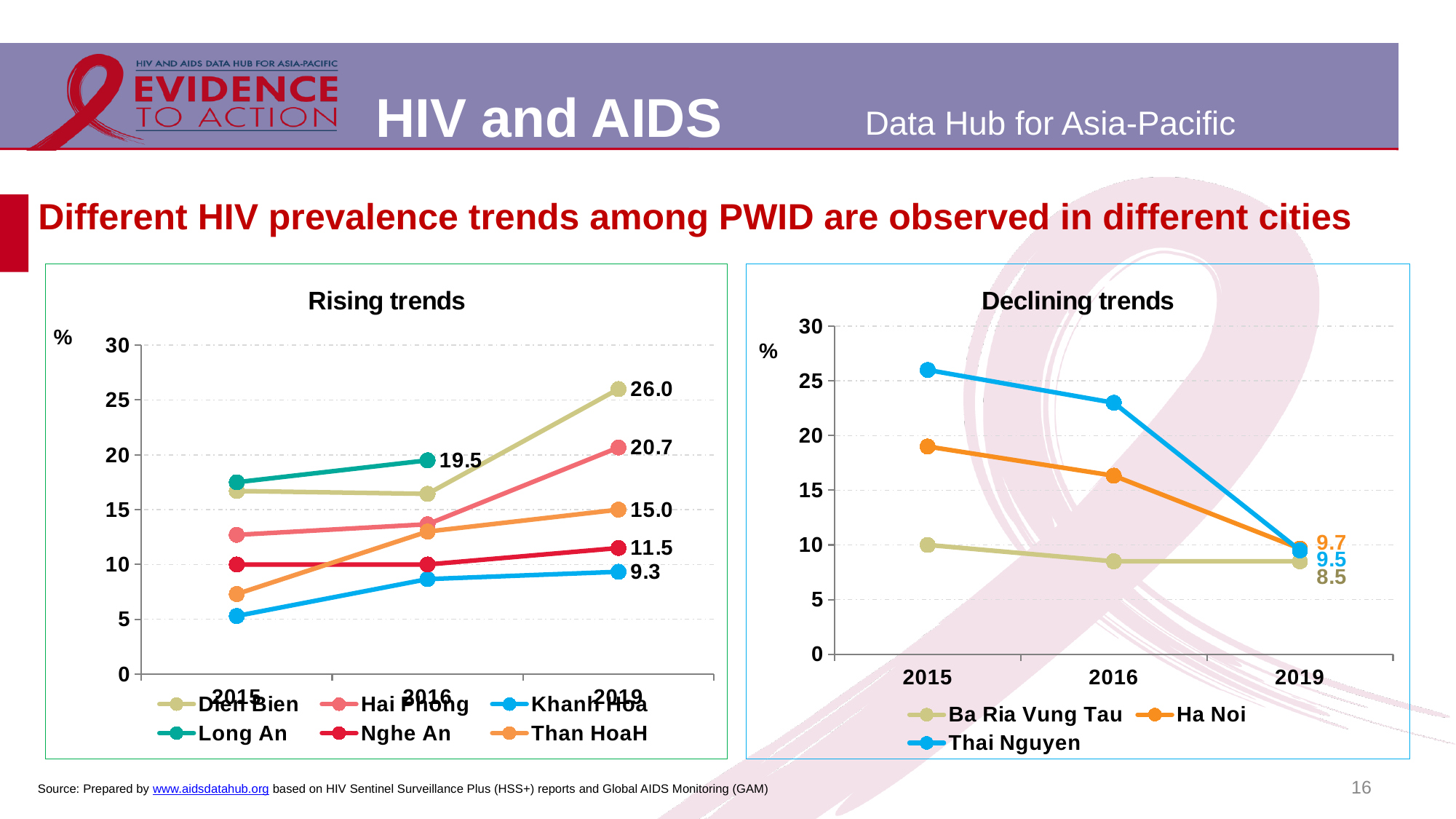
In the Rising trends chart, which city has the highest value in 2019? Dien Bien In the Rising trends chart, which city has the lowest value in 2019? Khanh Hoa In the Rising trends chart, what is the value for Dien Bien in 2019? 26.0 In the Declining trends chart, is the value for Thai Nguyen in 2015 greater or less than 25? greater In the Rising trends chart, what is the value for Long An in 2016? 19.5 How many series does the legend of the Rising trends chart list? 6 In the Rising trends chart, what is the value for Hai Phong in 2019? 20.7 In the Rising trends chart, what is the difference between the 2019 values for Dien Bien and Hai Phong? 5.3 In the Declining trends chart, what is the value for Ba Ria Vung Tau in 2019? 8.5 What kind of chart is the Declining trends chart? line chart In the Declining trends chart, does the value for Thai Nguyen rise or fall from 2015 to 2019? fall In the Declining trends chart, what is the value for Ha Noi in 2019? 9.7